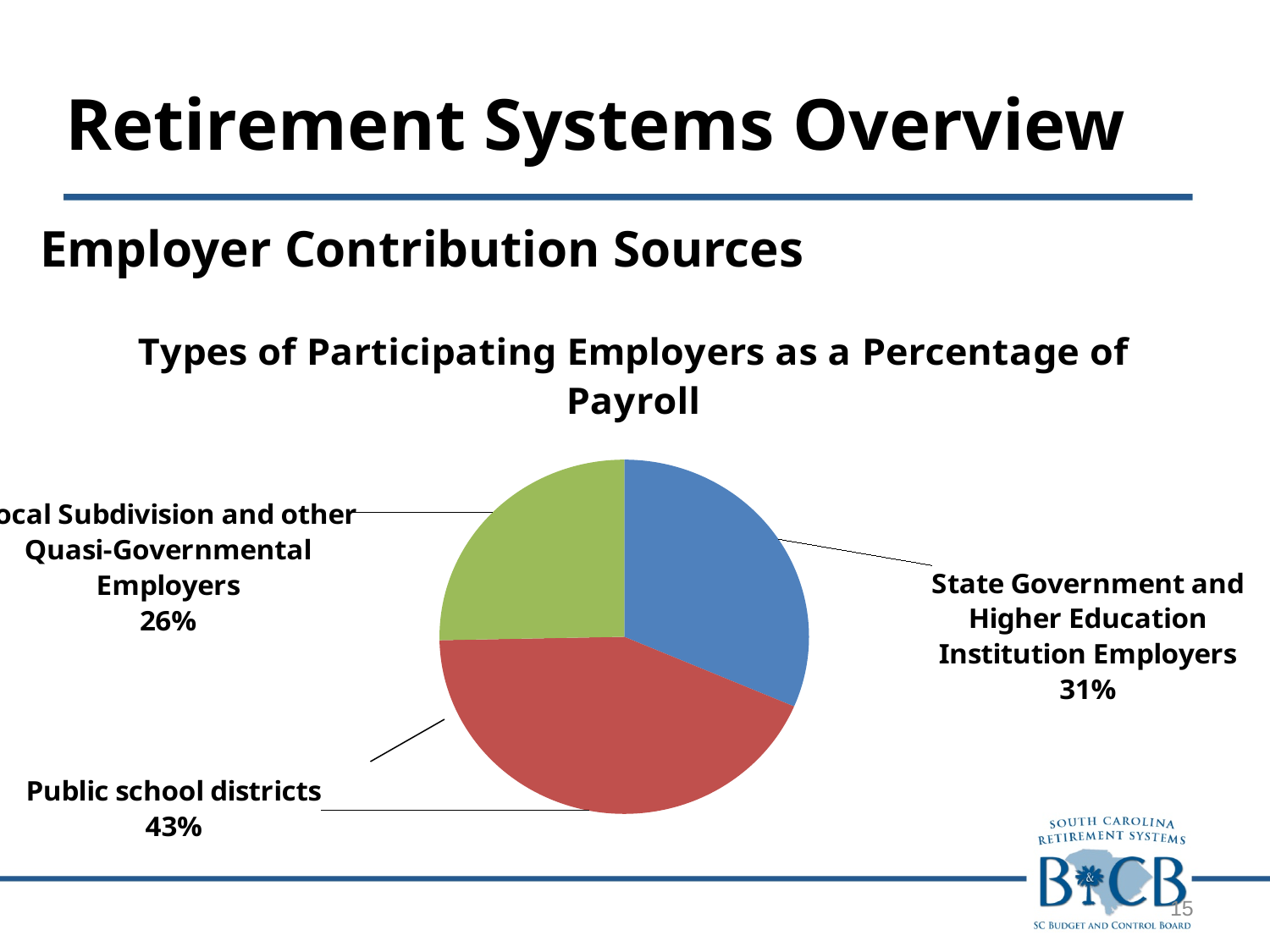
What colour is the slice for Public school districts? Red Which type of participating employer has the smallest share of payroll? Local Subdivision and other Quasi-Governmental Employers What percentage of payroll is attributed to State Government and Higher Education Institution Employers? 31% What kind of chart is shown on the slide? Pie chart Which has a larger share of payroll: State Government and Higher Education Institution Employers or Local Subdivision and other Quasi-Governmental Employers? State Government and Higher Education Institution Employers What is the difference in percentage points between Public school districts and State Government and Higher Education Institution Employers? 12 What is the combined share of payroll for State Government and Higher Education Institution Employers and Local Subdivision and other Quasi-Governmental Employers? 57% What percentage of payroll is attributed to Public school districts? 43% How many slices does the pie chart have? 3 What percentage of payroll is attributed to Local Subdivision and other Quasi-Governmental Employers? 26% What is the title of the chart? Types of Participating Employers as a Percentage of Payroll Which type of participating employer has the largest share of payroll? Public school districts